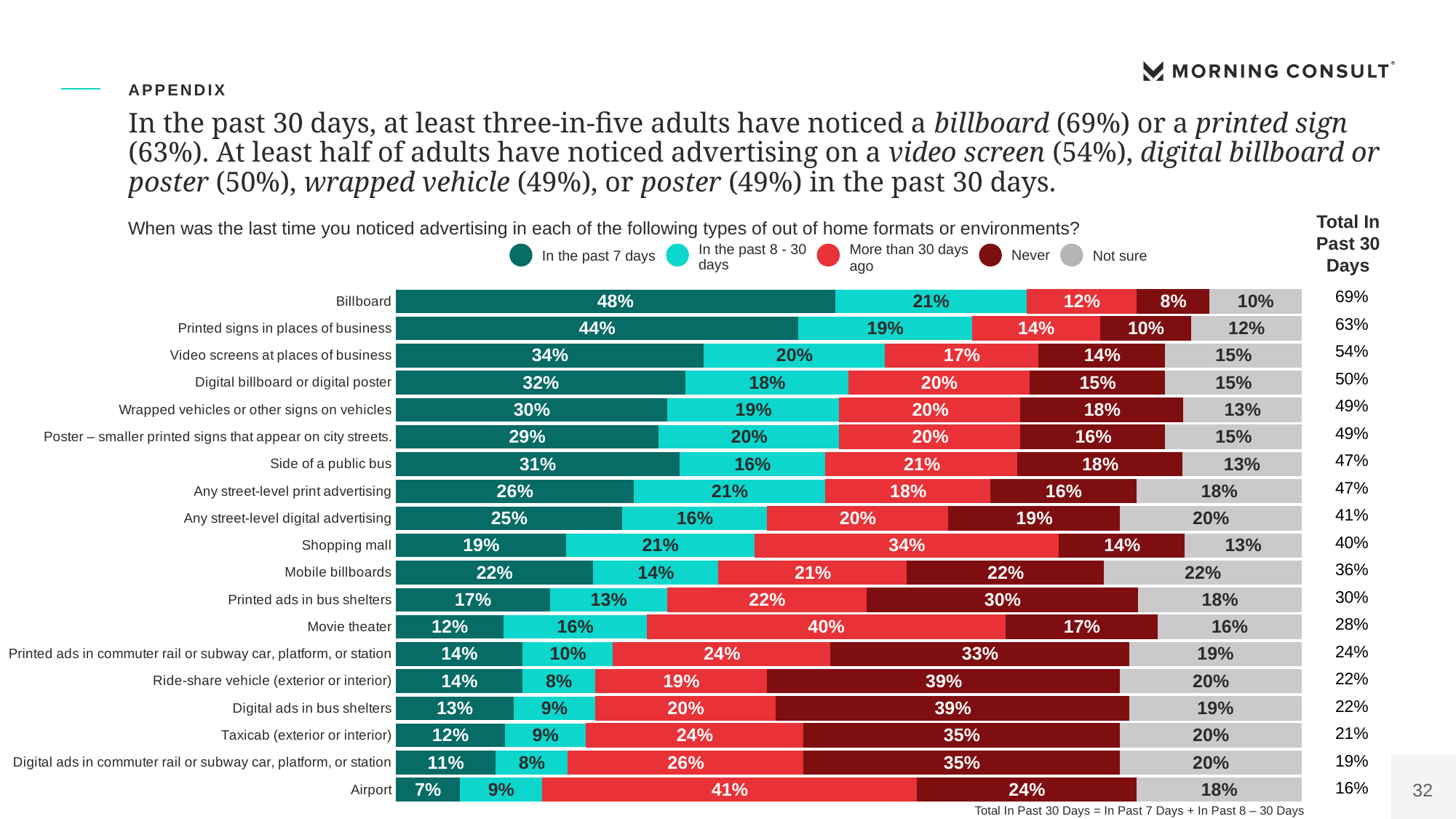
What percentage of adults noticed a Billboard in the past 7 days? 48% Which format has the highest 'In the past 7 days' value? Billboard What is the difference between the 'In the past 7 days' values for Billboard and Airport? 41 percentage points How many series does the legend list? 5 What is the 'Total In Past 30 Days' value for Printed signs in places of business? 63% How many out of home formats are listed in the chart? 19 What kind of chart is shown on the slide? Stacked bar chart Which has a larger 'More than 30 days ago' value: Shopping mall or Airport? Airport What is the 'Not sure' value for Mobile billboards? 22% What is the 'Never' value for Ride-share vehicle (exterior or interior)? 39% Which format has the lowest 'In the past 7 days' value? Airport What is the 'More than 30 days ago' value for Movie theater? 40%